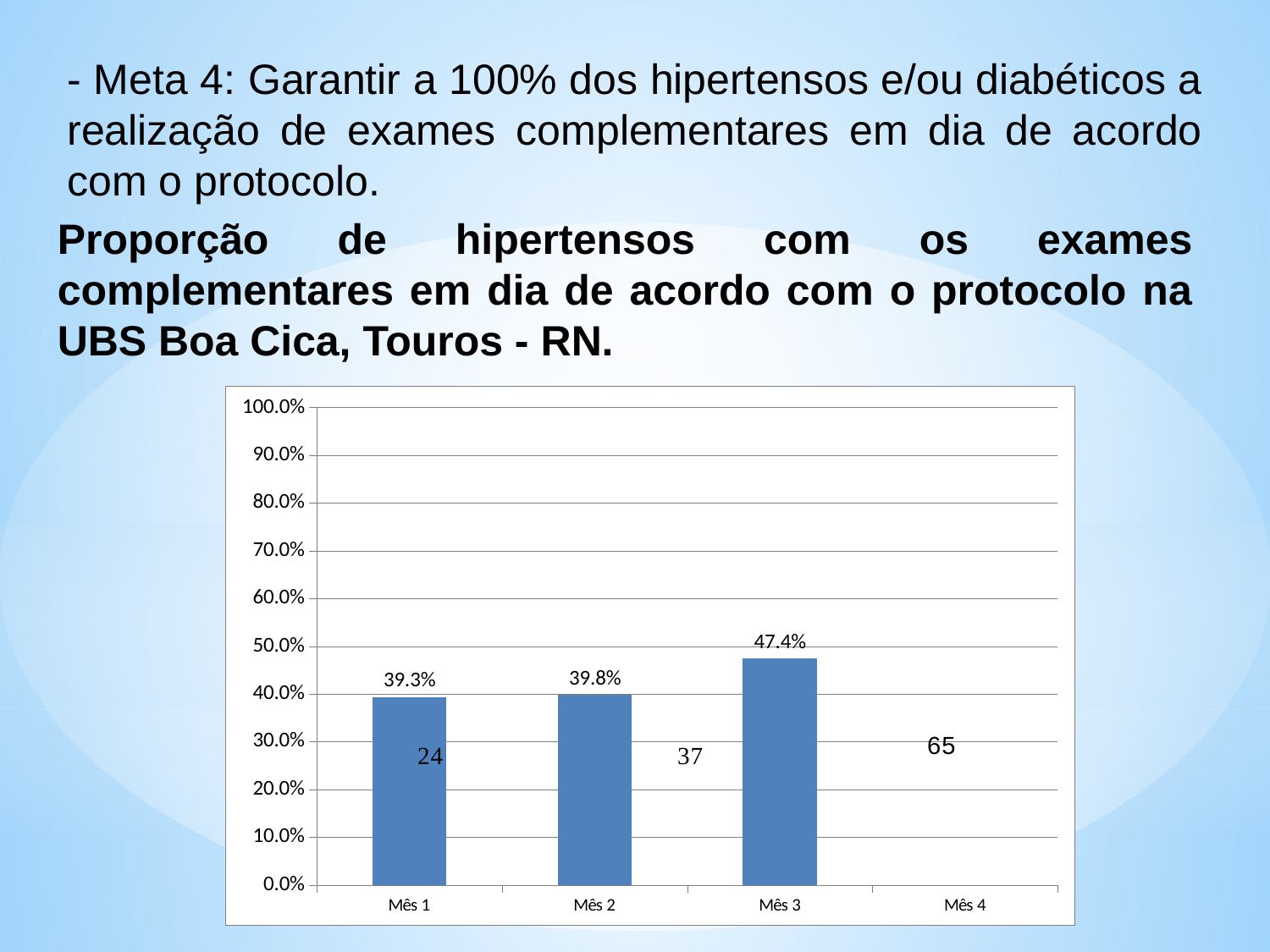
What is the difference between the values for Mês 3 and Mês 1? 8.1 percentage points Which of the months with a plotted bar has the lowest value? Mês 1 Which month has the highest value? Mês 3 Do the values rise or fall from Mês 1 to Mês 3? Rise What is the value for Mês 1? 39.3% Which is larger, the value for Mês 3 or the value for Mês 2? Mês 3 What is the difference between the values for Mês 2 and Mês 1? 0.5 percentage points Is the value for Mês 3 greater or less than 40%? greater What kind of chart is shown on the slide? Bar chart What is the value for Mês 2? 39.8% What is the value for Mês 3? 47.4% How many month categories are shown on the x axis? 4